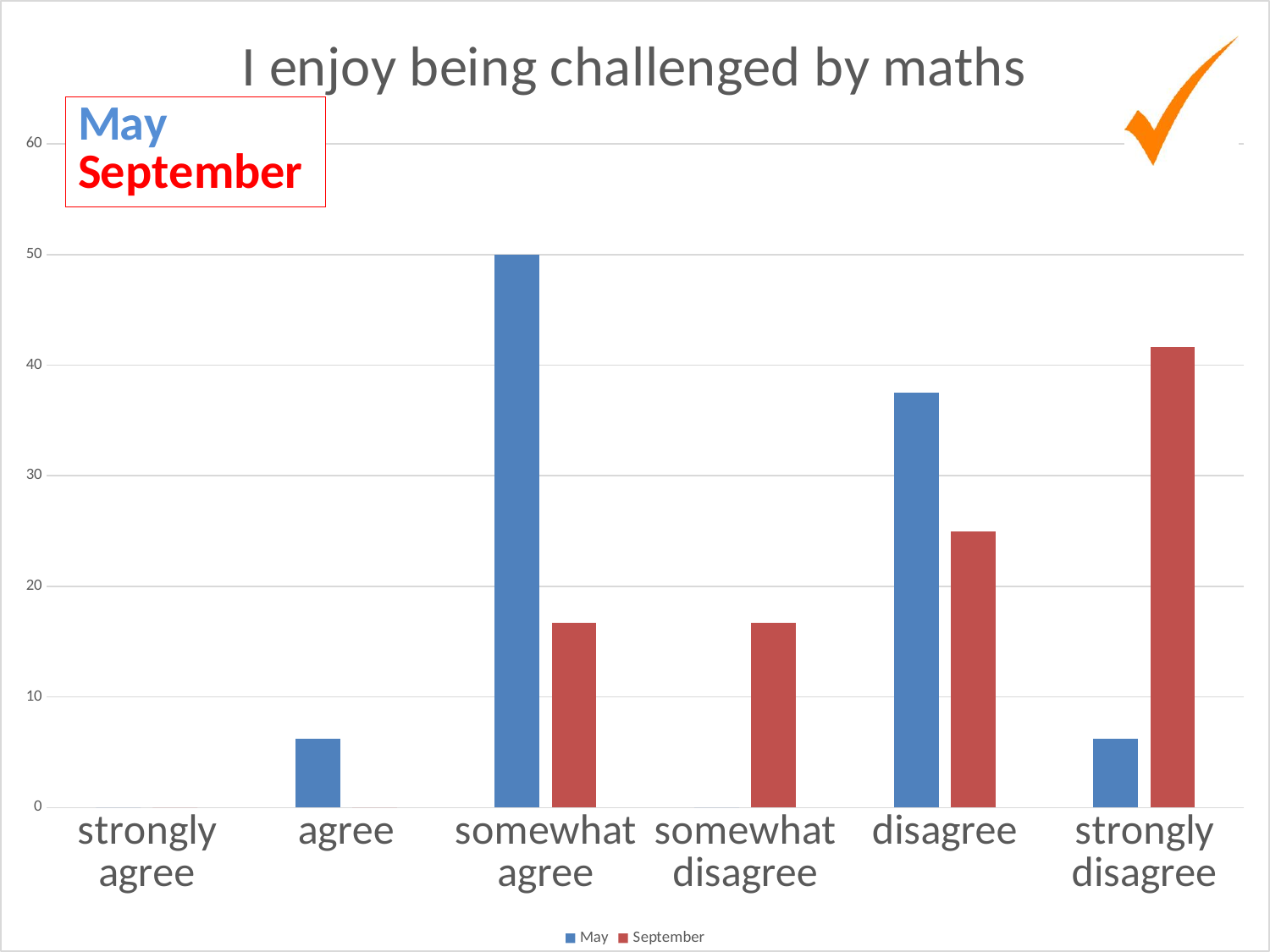
Which category has the highest September value? strongly disagree What kind of chart is shown on the slide? bar chart What is the title of the chart? I enjoy being challenged by maths Is the May value for 'disagree' greater or less than 30? greater For 'disagree', which series has the larger value, May or September? May What is the May value for 'somewhat agree'? 50 Is the September value for 'strongly disagree' greater or less than 40? greater Which category has the highest May value? somewhat agree How many series does the legend list? 2 Is the September value for 'somewhat agree' greater or less than 20? less For 'strongly disagree', which series has the larger value, May or September? September How many response categories are shown on the x axis? 6